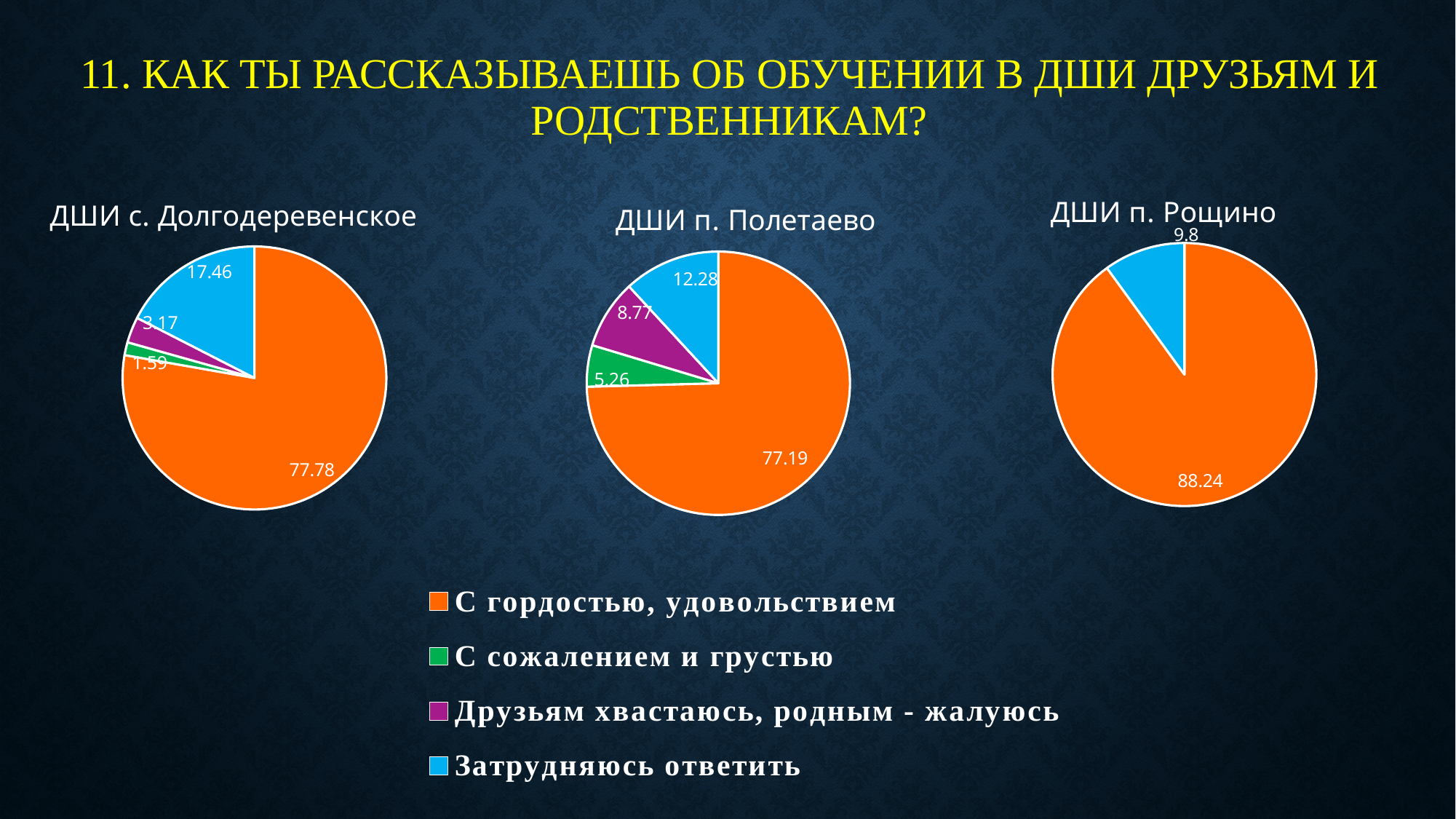
How many entries does the legend list? 4 In the 'ДШИ п. Полетаево' chart, which is larger: 'С сожалением и грустью' or 'Друзьям хвастаюсь, родным - жалуюсь'? Друзьям хвастаюсь, родным - жалуюсь In the 'ДШИ п. Полетаево' chart, what is the value for 'Затрудняюсь ответить'? 12.28 In the 'ДШИ п. Рощино' chart, what is the value for 'С гордостью, удовольствием'? 88.24 In the 'ДШИ с. Долгодеревенское' chart, what is the difference between the values for 'Затрудняюсь ответить' and 'Друзьям хвастаюсь, родным - жалуюсь'? 14.29 In the 'ДШИ с. Долгодеревенское' chart, which category has the smallest slice? С сожалением и грустью In the 'ДШИ с. Долгодеревенское' chart, what is the value for 'С гордостью, удовольствием'? 77.78 Which chart has the larger value for 'Затрудняюсь ответить': 'ДШИ с. Долгодеревенское' or 'ДШИ п. Рощино'? ДШИ с. Долгодеревенское In the 'ДШИ п. Полетаево' chart, what is the value for 'Друзьям хвастаюсь, родным - жалуюсь'? 8.77 In the 'ДШИ п. Полетаево' chart, which category has the largest slice? С гордостью, удовольствием What type of chart is used on this slide? Pie chart How many slices does the 'ДШИ п. Полетаево' chart have? 4